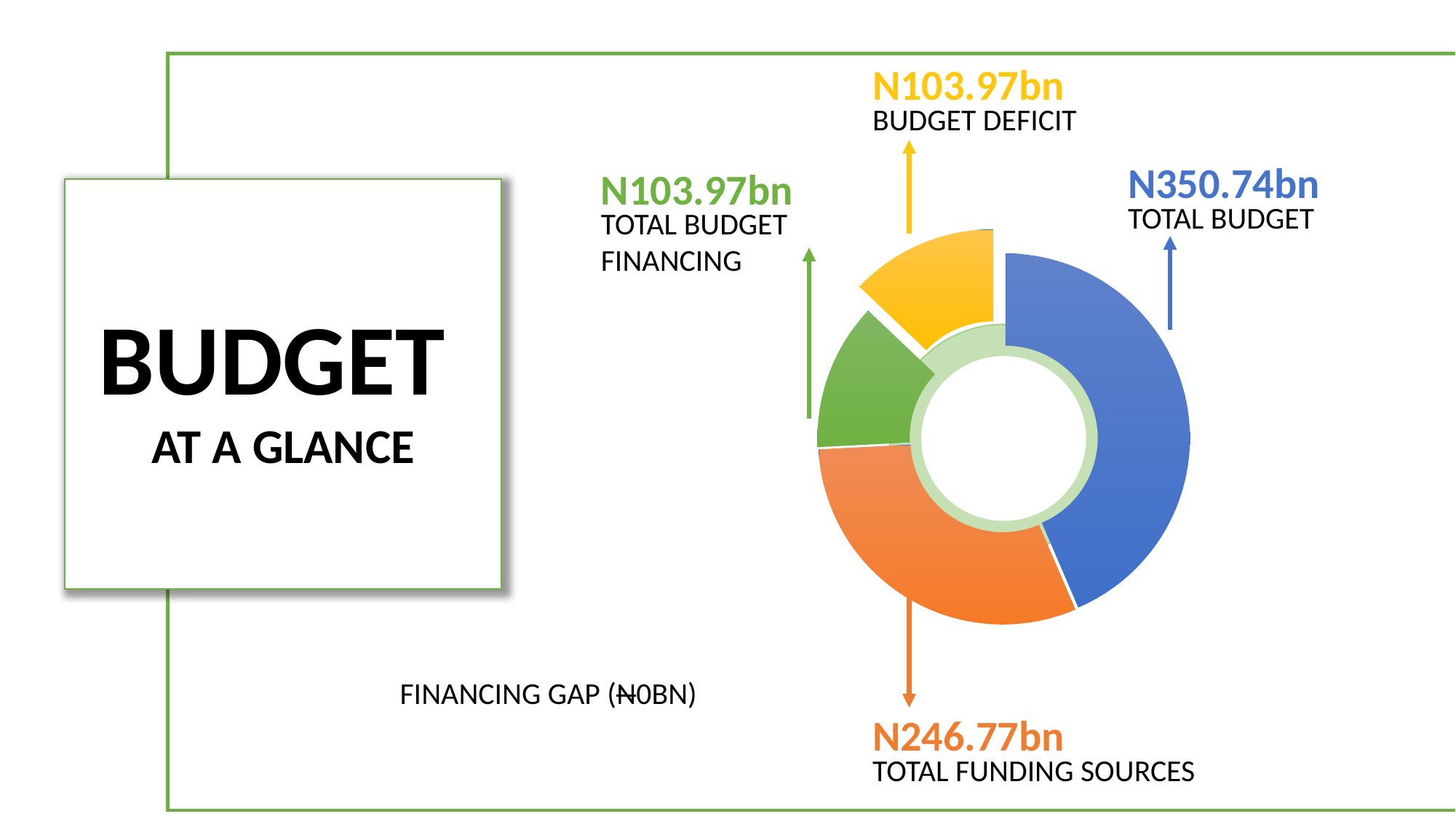
What is the value shown for Total Budget? N350.74bn How many segments does the doughnut chart have? 4 What is the difference between Total Budget and Total Funding Sources? N103.97bn What financing gap is stated on the slide? N0BN Which segment of the chart has the largest value? Total Budget What is the value shown for Total Funding Sources? N246.77bn Which colour is used for the Budget Deficit segment? Yellow What is the difference between Total Funding Sources and Budget Deficit? N142.80bn What kind of chart is shown on the slide? Doughnut (pie) chart What is the value shown for Total Budget Financing? N103.97bn Which is larger, Total Budget or Total Funding Sources? Total Budget What is the value shown for Budget Deficit? N103.97bn